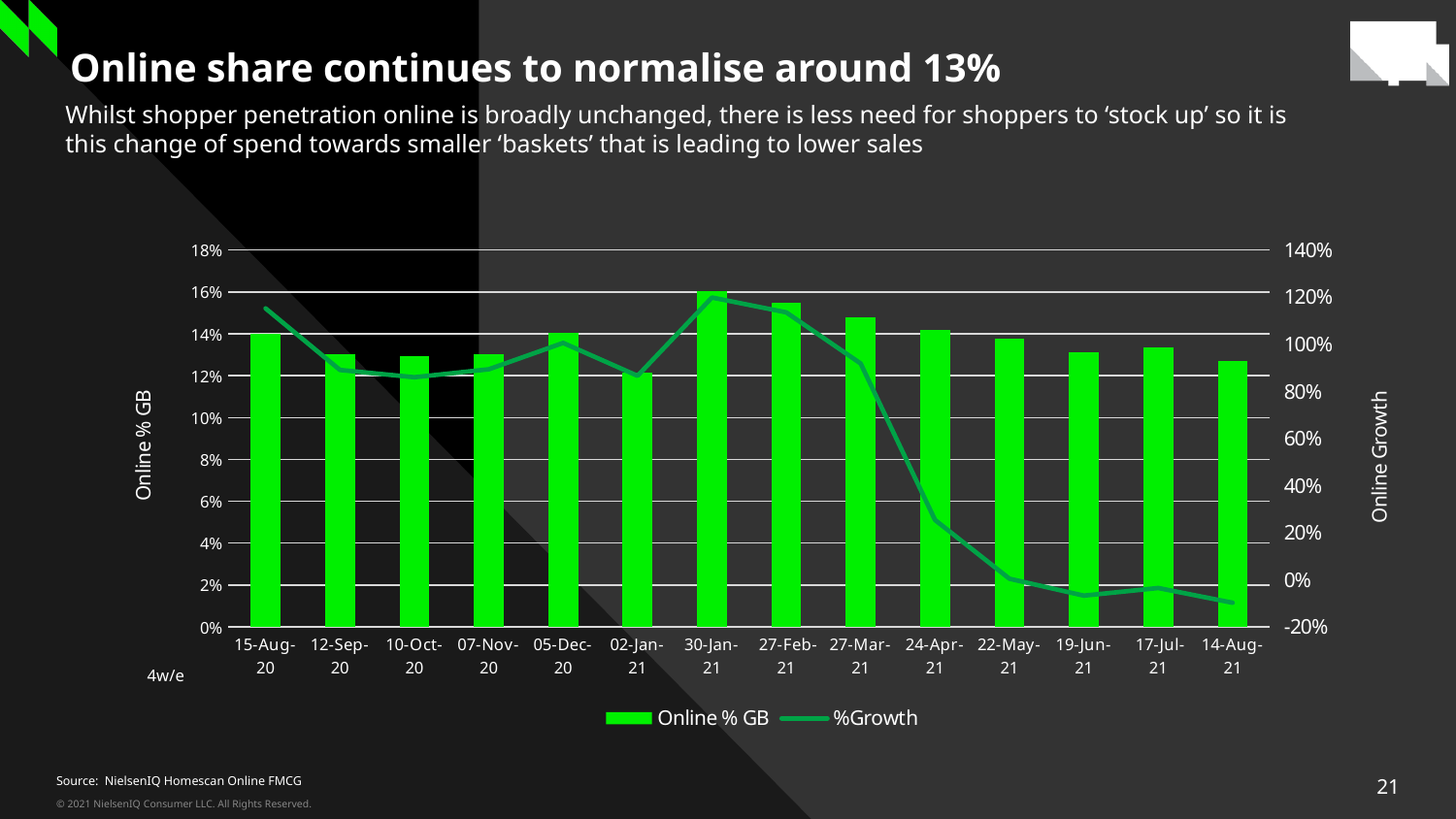
Which period has the highest Online % GB bar? 30-Jan-21 Is the Online % GB value for 30-Jan-21 greater or less than 14%? greater What are the two series named in the legend? Online % GB and %Growth How many 4w/e periods are shown on the x axis? 14 Is the %Growth value for 24-Apr-21 greater or less than 60%? less Is the %Growth value for 14-Aug-21 greater or less than 0%? less Which has the larger Online % GB bar, 30-Jan-21 or 15-Aug-20? 30-Jan-21 What kind of chart is shown on the slide? A combination bar and line chart Does the %Growth line rise or fall overall from 15-Aug-20 to 14-Aug-21? Fall How many series does the legend list? 2